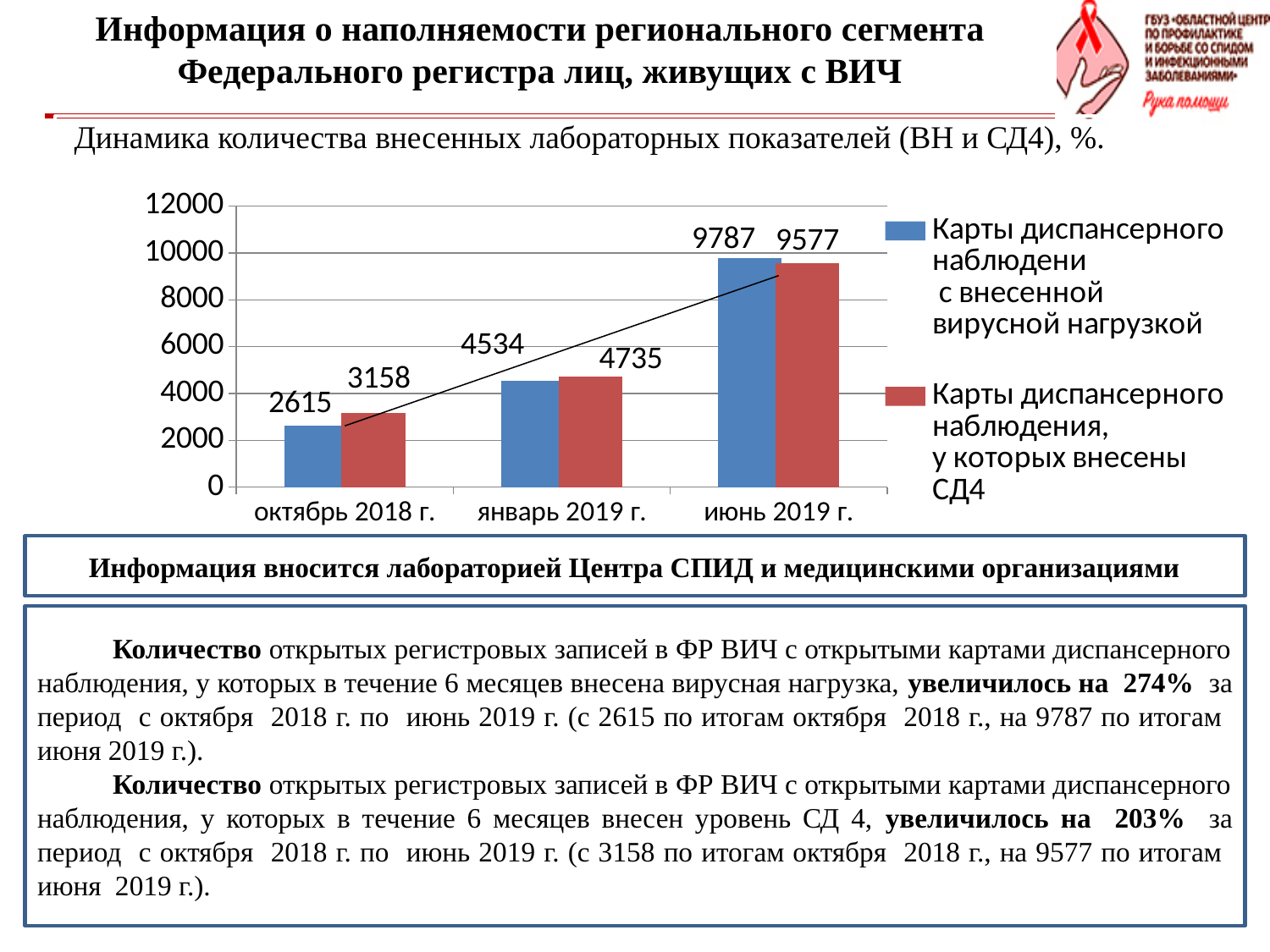
What is the difference between the two series' values in июнь 2019 г.? 210 How many series does the chart legend list? 2 In which period is the value for 'Карты диспансерного наблюдения с внесенной вирусной нагрузкой' the lowest? октябрь 2018 г. In which period is the value for 'Карты диспансерного наблюдения, у которых внесены СД4' the highest? июнь 2019 г. What type of chart is shown on the slide? bar chart What is the value for 'Карты диспансерного наблюдения с внесенной вирусной нагрузкой' in июнь 2019 г.? 9787 How many categories are shown on the x axis of the chart? 3 What is the value for 'Карты диспансерного наблюдения, у которых внесены СД4' in январь 2019 г.? 4735 In октябрь 2018 г., which series has the larger value: the one with вирусной нагрузкой or the one with СД4? Карты диспансерного наблюдения, у которых внесены СД4 Do the values for 'Карты диспансерного наблюдения с внесенной вирусной нагрузкой' rise or fall from октябрь 2018 г. to июнь 2019 г.? rise What is the value for 'Карты диспансерного наблюдения с внесенной вирусной нагрузкой' in октябрь 2018 г.? 2615 What colour are the bars for 'Карты диспансерного наблюдения, у которых внесены СД4'? red